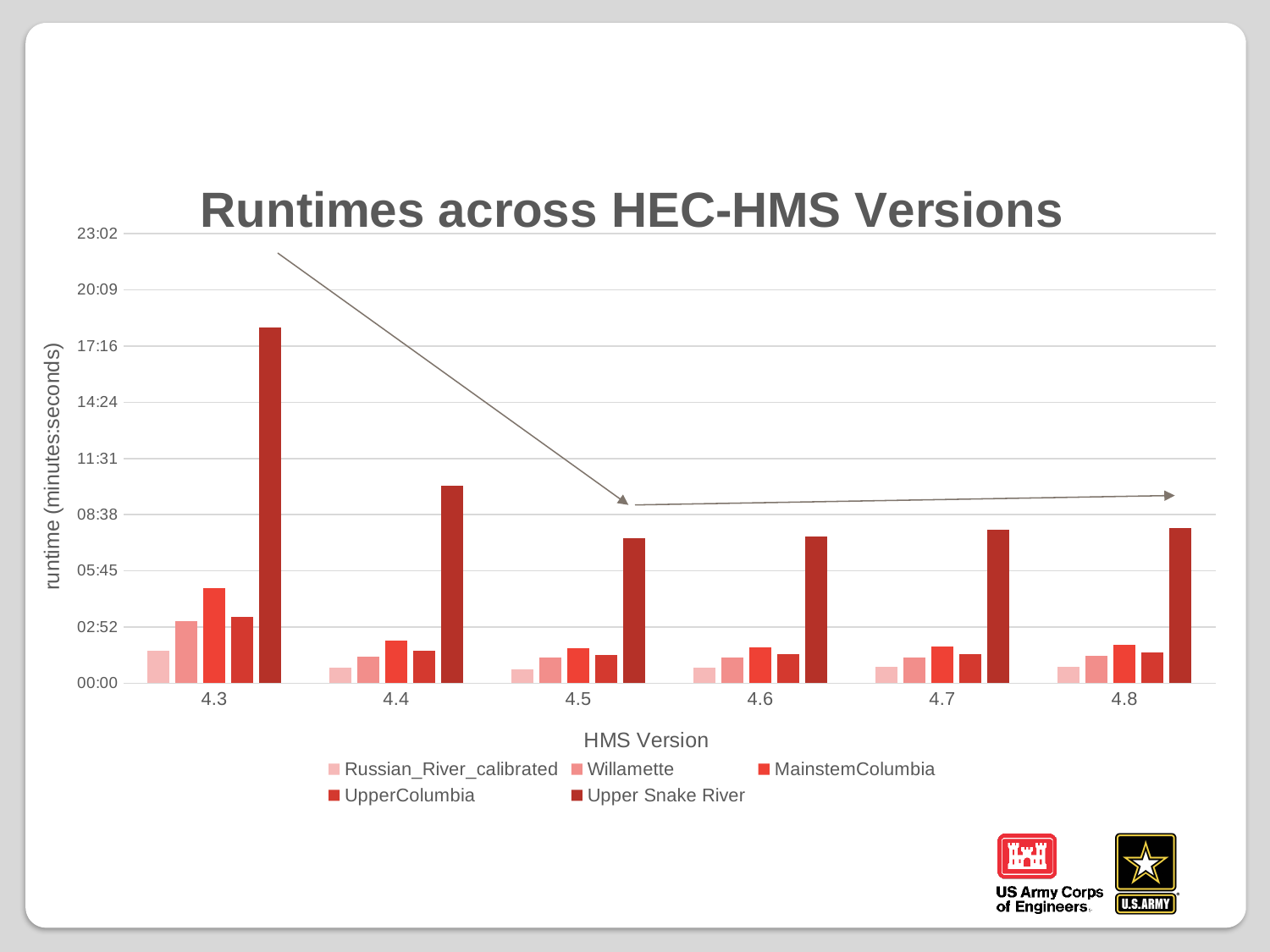
What type of chart is shown on the slide? bar chart How many series does the legend list? 5 Is the Upper Snake River runtime for version 4.5 greater or less than 08:38? less Which is larger, the Upper Snake River runtime for version 4.3 or for version 4.4? 4.3 Does the Upper Snake River runtime rise or fall from version 4.3 to version 4.5? fall Is the Upper Snake River runtime for version 4.3 greater or less than 17:16? greater Which series has the lowest runtime for HMS version 4.4? Russian_River_calibrated What is the title of the chart? Runtimes across HEC-HMS Versions How many HMS versions are shown on the x axis? 6 Is the MainstemColumbia runtime for version 4.3 greater or less than 05:45? less Which series has the highest runtime for HMS version 4.3? Upper Snake River For which HMS version is the Upper Snake River runtime highest? 4.3